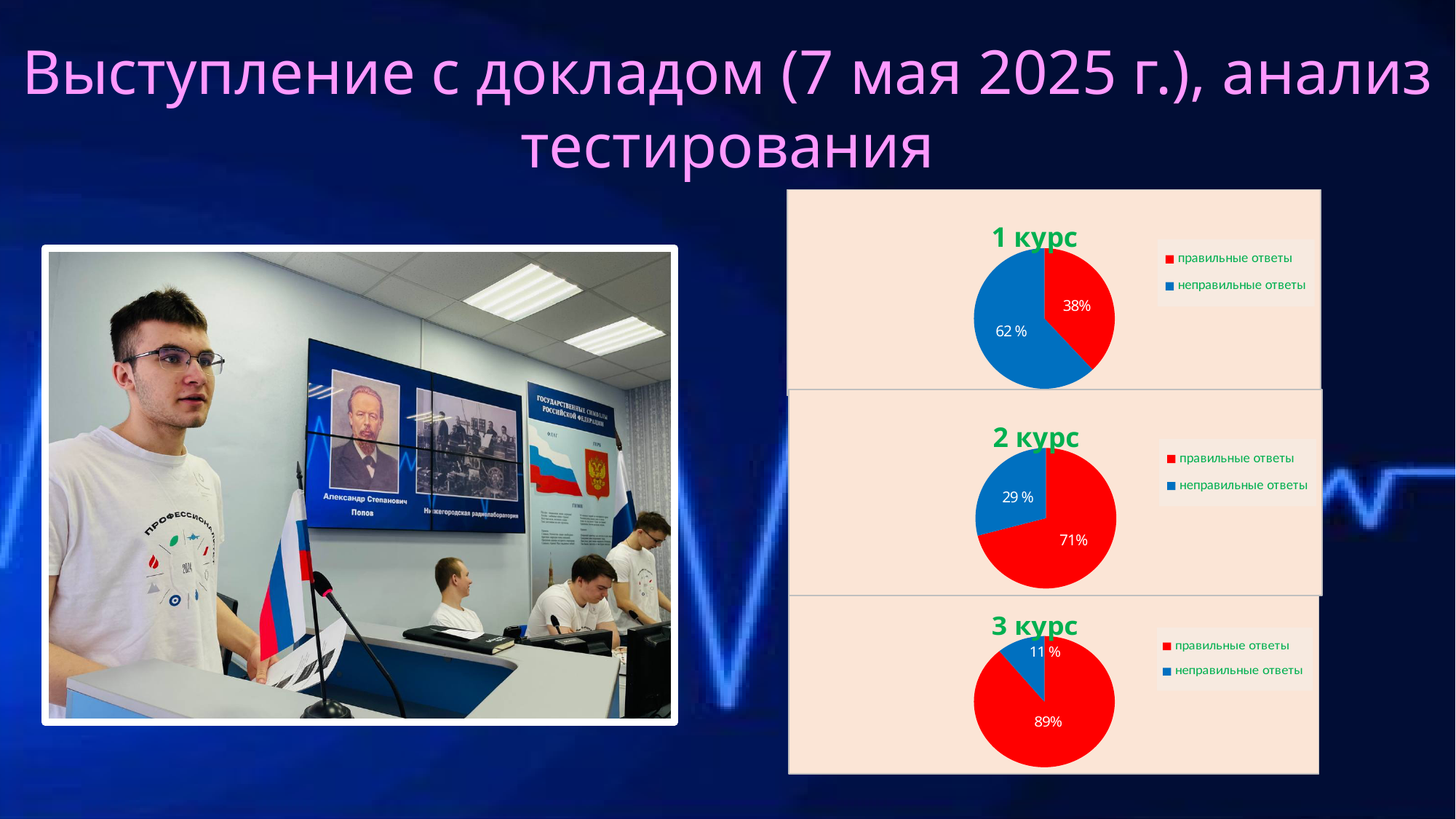
In the '1 курс' chart, what share of answers were неправильные ответы? 62 % In the '2 курс' chart, what share of answers were неправильные ответы? 29 % In the '2 курс' chart, what is the difference in percentage points between правильные ответы and неправильные ответы? 42 In the '3 курс' chart, what share of answers were правильные ответы? 89% What kind of chart is the '1 курс' chart? Pie chart In the '3 курс' chart, what colour is the slice for правильные ответы? Red In the '3 курс' chart, what share of answers were неправильные ответы? 11 % In the '2 курс' chart, what share of answers were правильные ответы? 71% In the '1 курс' chart, which slice is larger: правильные ответы or неправильные ответы? неправильные ответы How many entries does the legend of the '2 курс' chart list? 2 In the '1 курс' chart, what share of answers were правильные ответы? 38% In the '3 курс' chart, which slice is the smallest? неправильные ответы